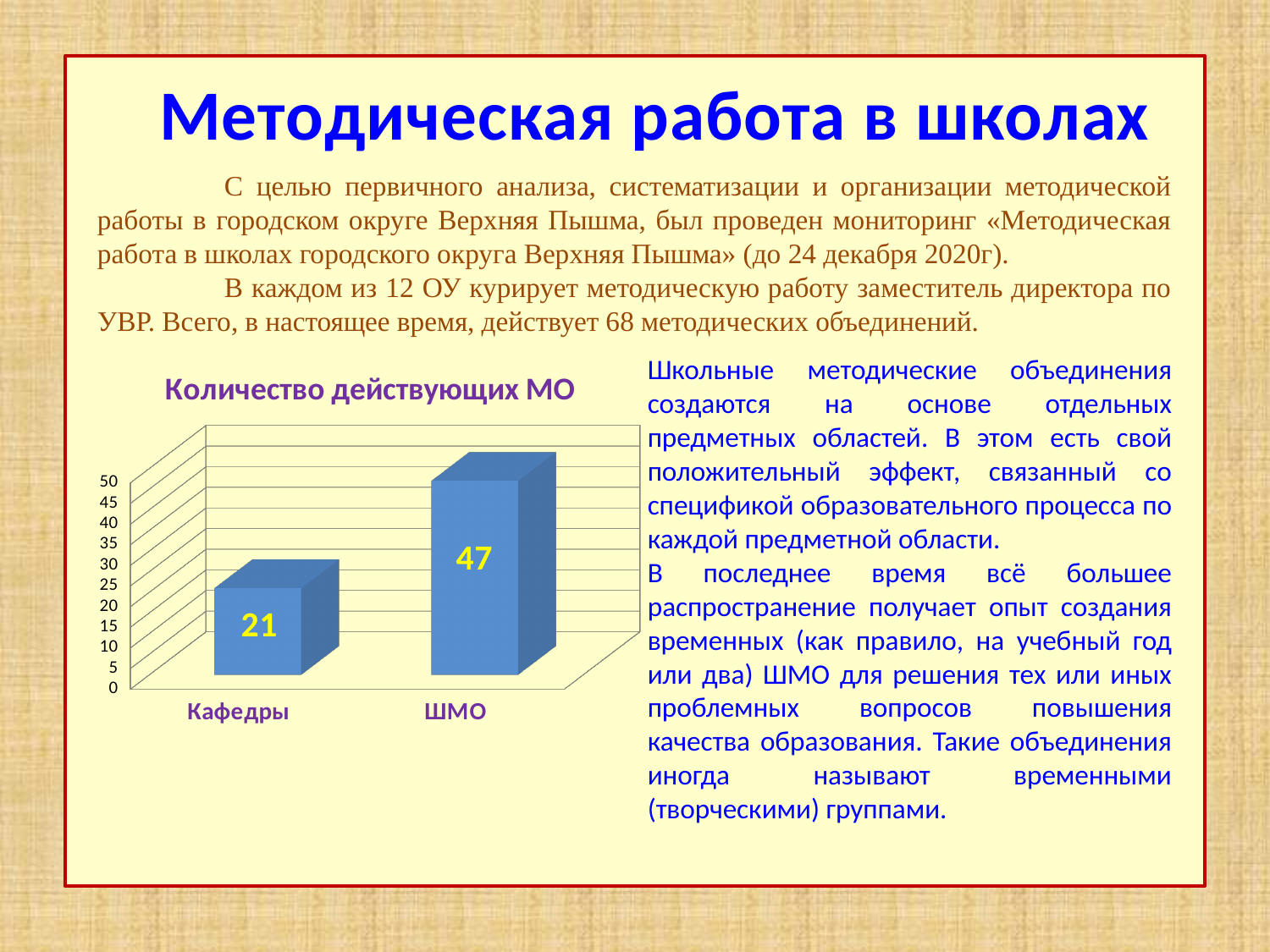
Which is larger, the value for Кафедры or the value for ШМО? ШМО What kind of chart is shown on the slide? bar chart How many categories are shown in the chart? 2 Which category has the lowest value? Кафедры What is the value for Кафедры? 21 What is the value for ШМО? 47 What is the difference between the values for ШМО and Кафедры? 26 What is the total of the two values shown in the chart? 68 Which category has the highest value? ШМО What is the title of the chart? Количество действующих МО Is the value for ШМО greater or less than 40? greater Is the value for Кафедры greater or less than 25? less